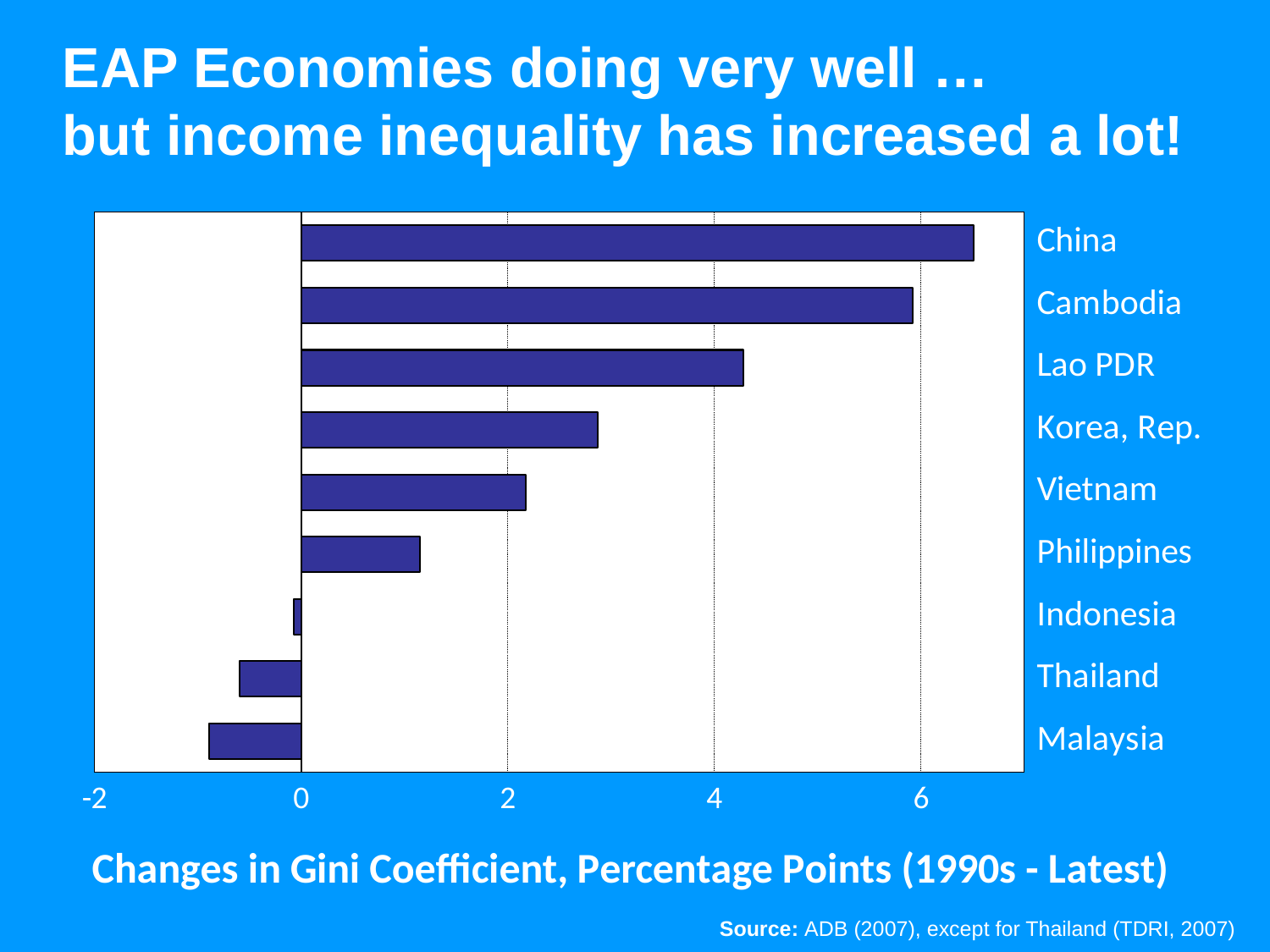
Is the value for Philippines greater or less than 2? less What is the caption below the chart? Changes in Gini Coefficient, Percentage Points (1990s - Latest) Is the value for China greater or less than 6? greater Is the value for Lao PDR greater or less than 4? greater How many economies are shown in the chart? 9 What kind of chart is shown on the slide? bar chart Which has the larger change in Gini coefficient, Korea, Rep. or Vietnam? Korea, Rep. Which economy has the largest change in Gini coefficient? China Which has the larger change in Gini coefficient, Cambodia or Lao PDR? Cambodia Which economy has the lowest (most negative) change in Gini coefficient? Malaysia